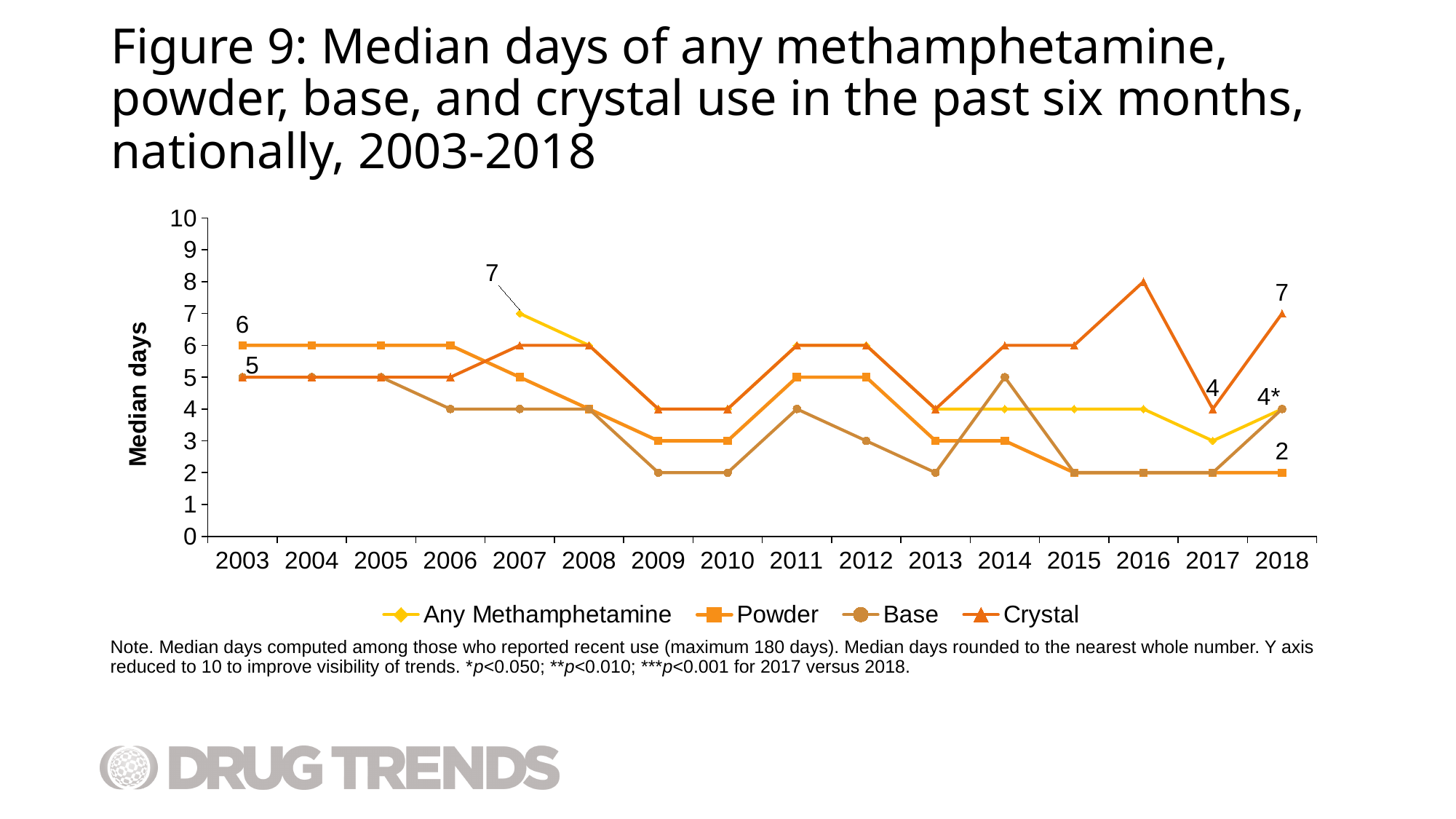
What was the median days of Powder use in 2003? 6 How many years are shown on the x axis? 16 In 2018, which had the higher median days: Crystal or Powder? Crystal What was the median days of Any Methamphetamine use in 2007? 7 What was the median days of Crystal use in 2018? 7 What is the label on the y axis? Median days What type of chart is shown on the slide? line chart In which year did the Crystal series reach its highest value? 2016 How many series does the legend list? 4 By how many days did the Crystal median increase from 2017 to 2018? 3 What was the median days of Crystal use in 2017? 4 What was the median days of Powder use in 2018? 2